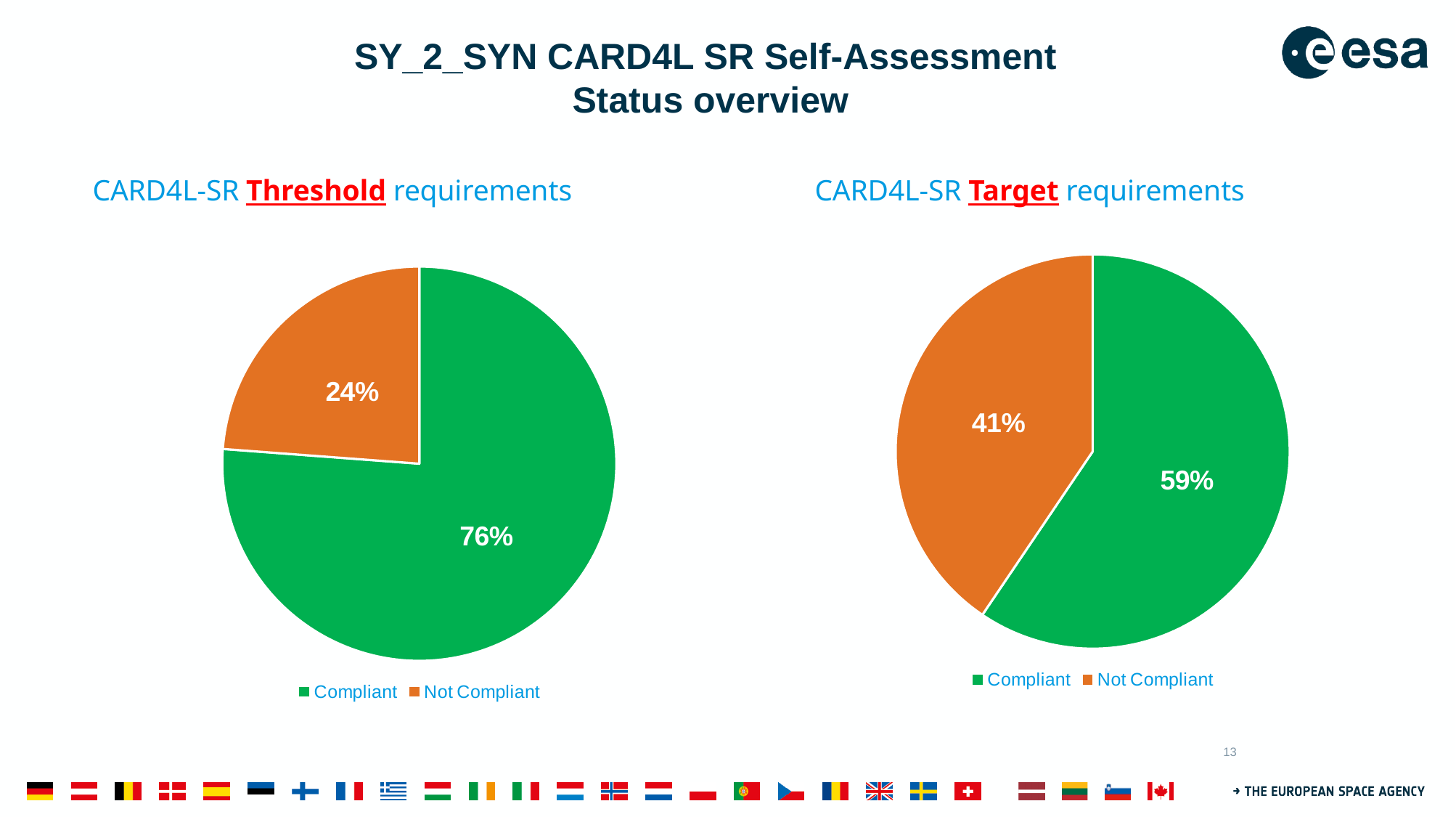
In the CARD4L-SR Target requirements chart, which slice is the smallest? Not Compliant In the CARD4L-SR Target requirements chart, what is the difference between the Compliant and Not Compliant shares? 18% In the CARD4L-SR Threshold requirements chart, what is the difference between the Compliant and Not Compliant shares? 52% In the CARD4L-SR Target requirements chart, what percentage is Not Compliant? 41% In the CARD4L-SR Threshold requirements chart, what percentage is Compliant? 76% What kind of chart is the CARD4L-SR Target requirements chart? Pie chart In the CARD4L-SR Target requirements chart, what colour is the Not Compliant slice? Orange In the CARD4L-SR Target requirements chart, what percentage is Compliant? 59% In the CARD4L-SR Threshold requirements chart, what percentage is Not Compliant? 24% How many categories does the legend of the CARD4L-SR Threshold requirements chart list? 2 Is the Compliant share larger in the CARD4L-SR Threshold requirements chart or the CARD4L-SR Target requirements chart? CARD4L-SR Threshold requirements In the CARD4L-SR Threshold requirements chart, which slice is the largest? Compliant